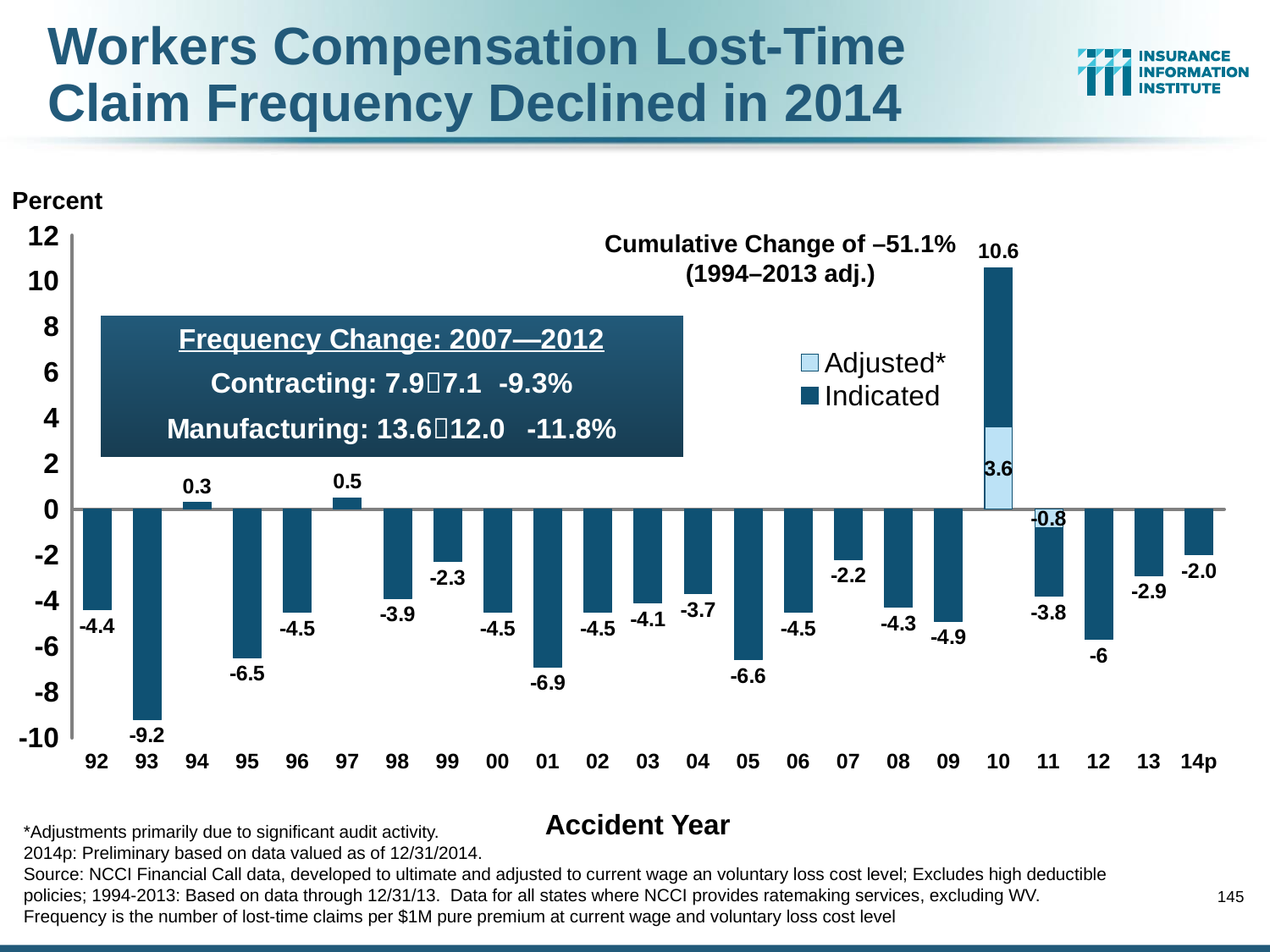
What is the value for accident year 93? -9.2 What is the Adjusted value shown for accident year 10? 3.6 What is the value for accident year 14p? -2.0 Which is larger, the value for accident year 95 or for accident year 99? 99 Which accident year has the highest value? 10 How many series does the legend list? 2 What is the x-axis title of the chart? Accident Year Which accident year has the lowest value? 93 What is the difference between the values for accident years 12 and 13? 3.1 How many accident years are shown on the x axis? 23 What cumulative change for 1994–2013 (adj.) is stated on the chart? –51.1% What kind of chart is this? Bar chart